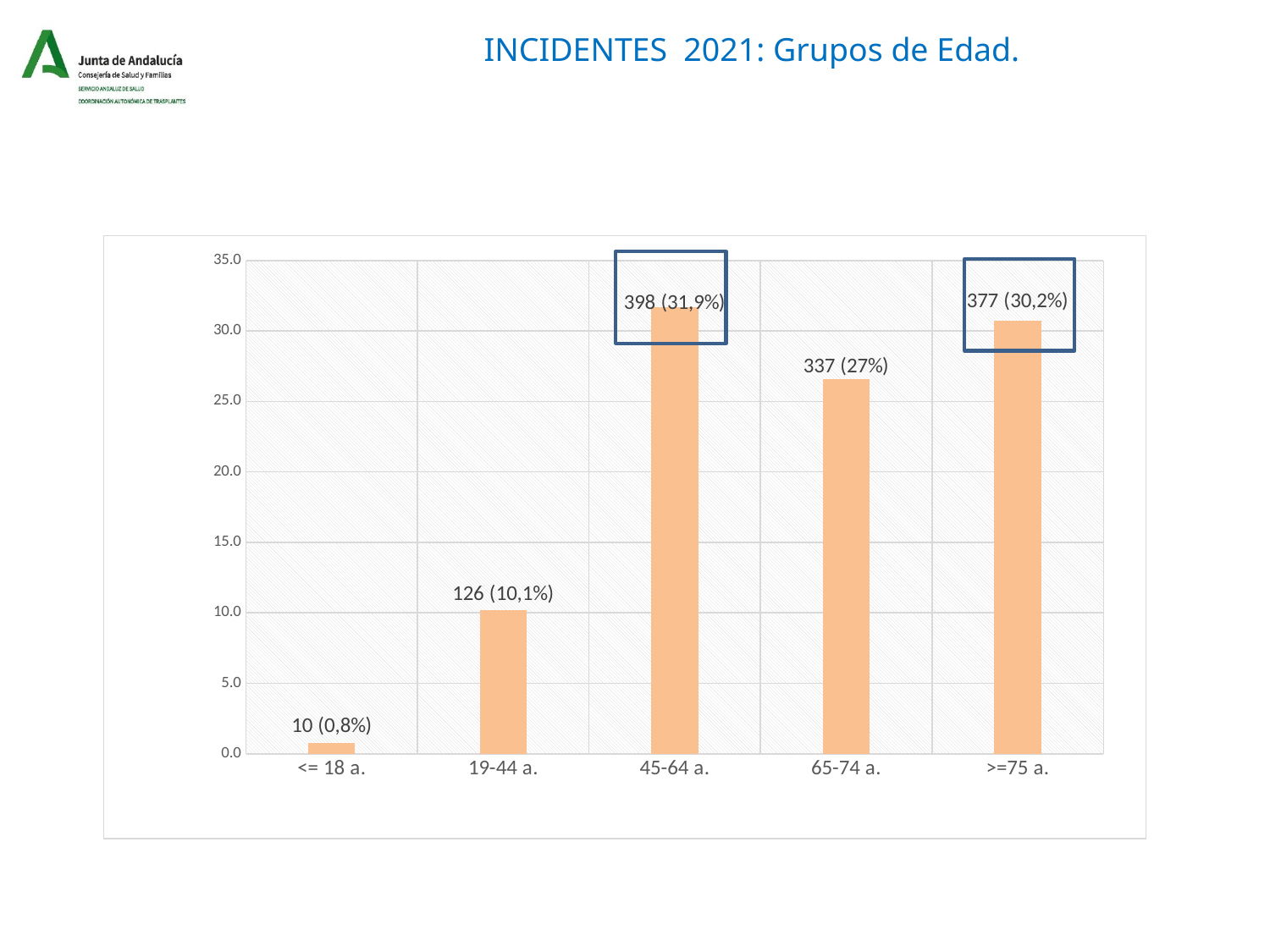
What is the data label shown for the 19-44 a. age group? 126 (10,1%) What is the difference in incident count between the 45-64 a. and >=75 a. groups? 21 Which age group has the highest value? 45-64 a. How many age groups are shown on the x axis? 5 Which has a larger value, 65-74 a. or >=75 a.? >=75 a. What is the data label shown for the 45-64 a. age group? 398 (31,9%) What kind of chart is shown on the slide? bar chart What is the data label shown for the <= 18 a. age group? 10 (0,8%) What is the title of the slide? INCIDENTES 2021: Grupos de Edad. Is the bar for 19-44 a. greater or less than 15.0 on the axis? less What is the data label shown for the 65-74 a. age group? 337 (27%) Which age group has the lowest value? <= 18 a.